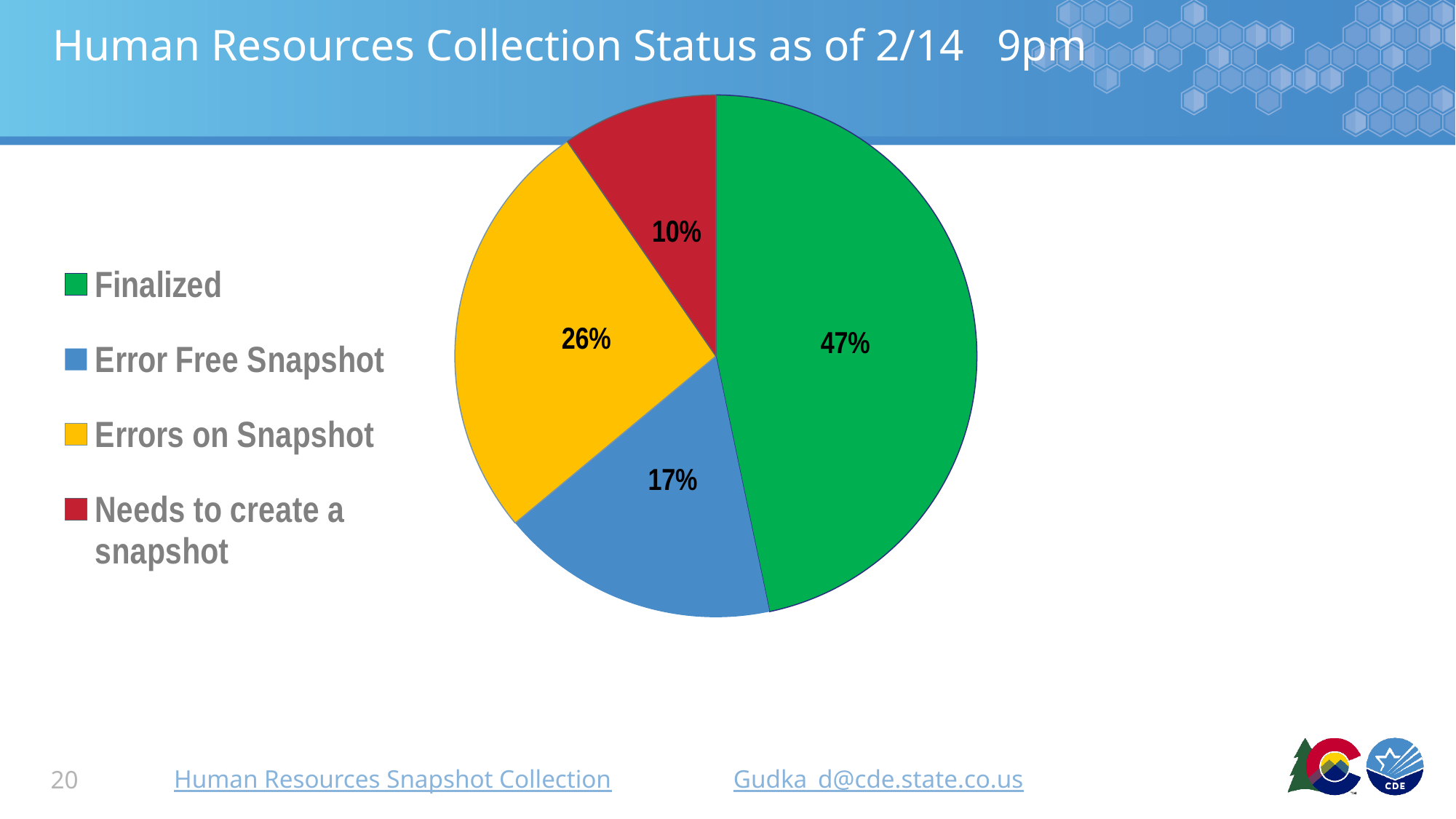
What share of the pie does Error Free Snapshot represent? 17% What share of the pie does Errors on Snapshot represent? 26% Which category has the largest slice of the pie? Finalized How many categories does the pie chart have? 4 What is the difference in percentage points between Finalized and Errors on Snapshot? 21 Which is larger, Errors on Snapshot or Error Free Snapshot? Errors on Snapshot Which category has the smallest slice of the pie? Needs to create a snapshot What share of the pie does Needs to create a snapshot represent? 10% What is the title of the slide containing the chart? Human Resources Collection Status as of 2/14 9pm What type of chart is shown on the slide? pie chart What colour is the Errors on Snapshot slice? yellow